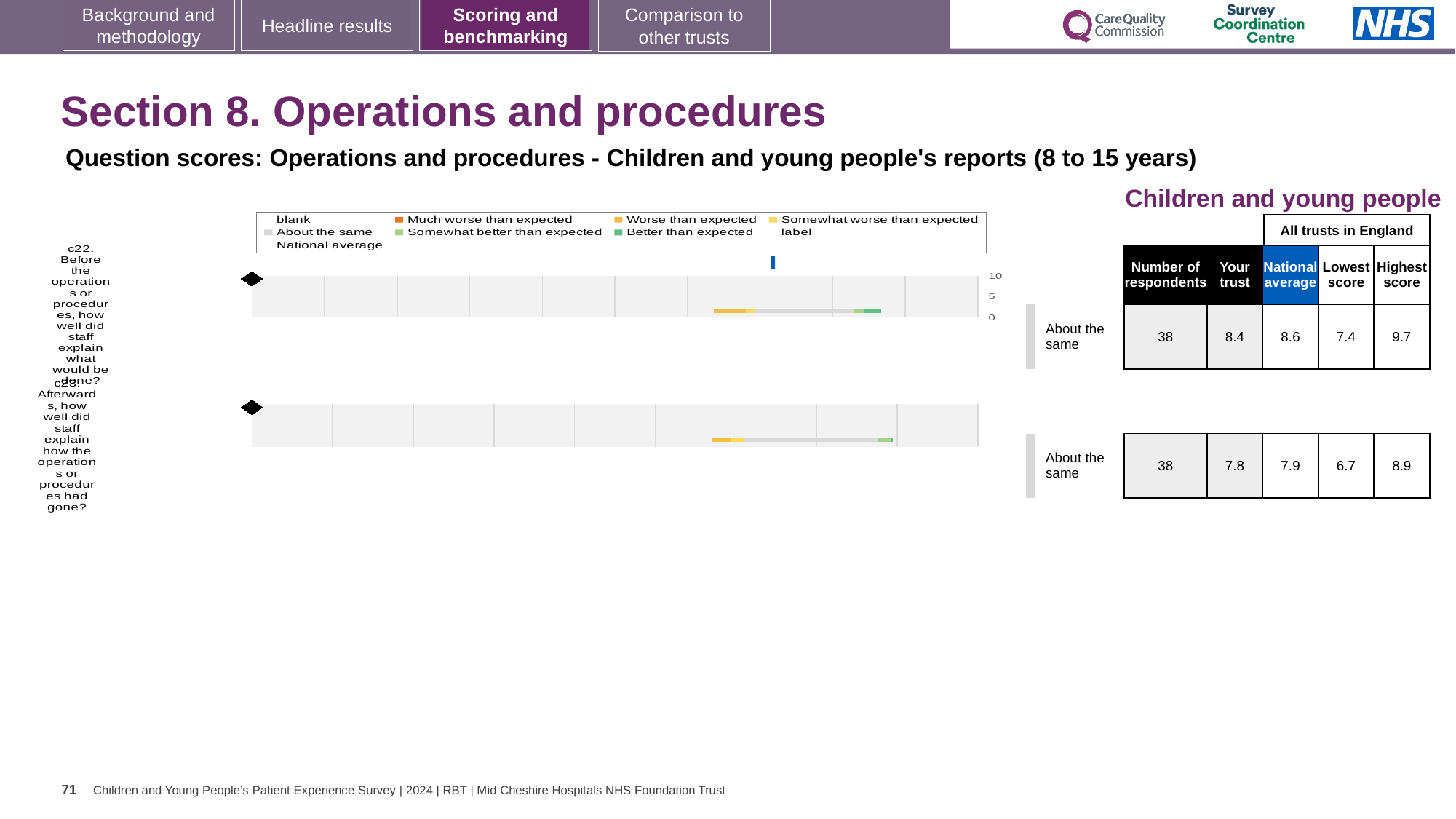
What is the difference between the national average and the trust's score for c23? 0.1 What is the 'Your trust' score for c22 (Before the operations or procedures, how well did staff explain what would be done?)? 8.4 How many respondents answered c22? 38 What is the difference between the highest and lowest scores for c22? 2.3 What benchmark category is shown for both c22 and c23? About the same How many questions (rows) are plotted in the chart? 2 What is the national average score for c22? 8.6 Which question has the higher 'Your trust' score, c22 or c23? c22 Which is larger for c22: the trust's score or the national average? National average What is the 'Your trust' score for c23 (Afterwards, how well did staff explain how the operations or procedures had gone?)? 7.8 What is the highest score among all trusts in England for c23? 8.9 What kind of chart is used to show the question scores for c22 and c23? bar chart